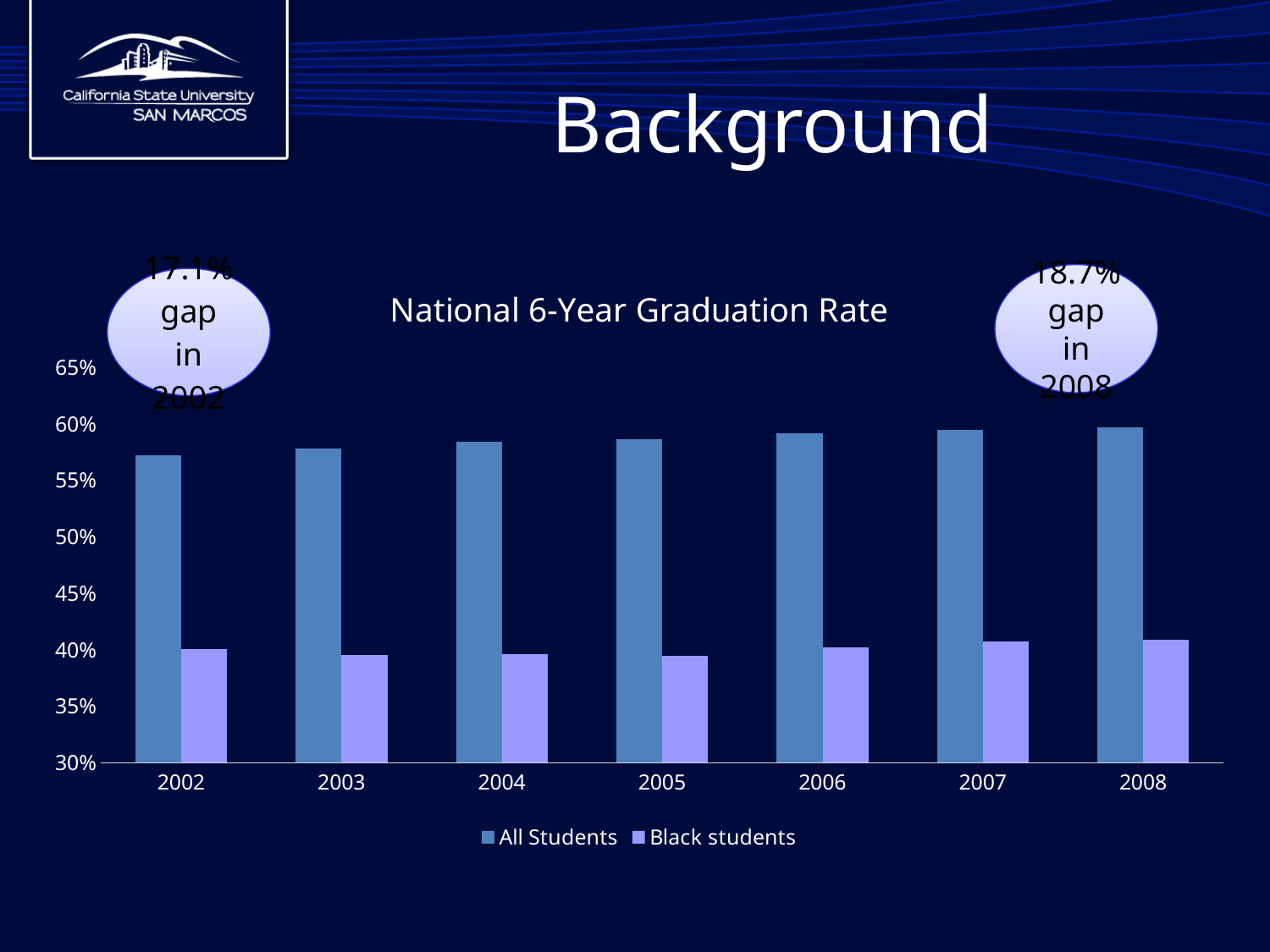
Is the All Students value for 2002 greater or less than 55%? greater Is the All Students value for 2002 greater or less than 60%? less Which year has the lowest All Students value? 2002 Is the Black students value for 2008 greater or less than 40%? greater How many series does the legend list? 2 What kind of chart is shown on the slide? bar chart What gap between the two groups does the callout give for 2002? 17.1% Does the All Students graduation rate rise or fall from 2002 to 2008? rise How many years are shown on the x axis? 7 What gap between the two groups does the callout give for 2008? 18.7% In 2006, which is larger: the All Students value or the Black students value? All Students